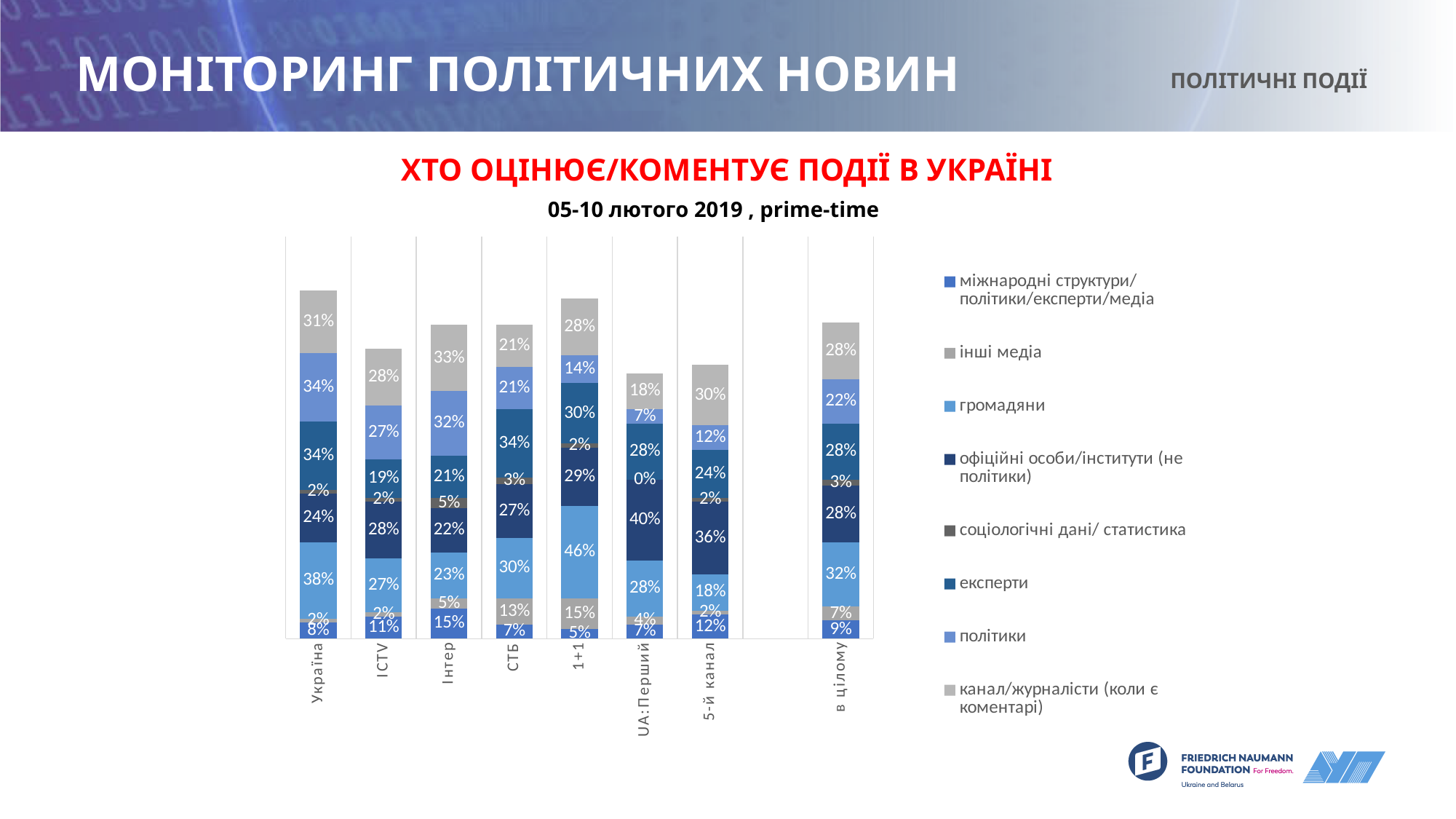
What type of chart is shown on the slide? Stacked bar chart What is the value of the 'громадяни' segment for 1+1? 46% What is the value of the 'офіційні особи/інститути (не політики)' segment for UA:Перший? 40% What is the value of the 'соціологічні дані/ статистика' segment for UA:Перший? 0% Which channel has the lowest value for 'міжнародні структури/політики/експерти/медіа'? 1+1 Which is larger: the 'політики' value for Україна or for ICTV? Україна What is the difference between the 'експерти' value for Україна and for 5-й канал? 10 percentage points How many series does the chart legend list? 8 What is the value of the 'міжнародні структури/політики/експерти/медіа' segment for Інтер? 15% What is the value of the 'канал/журналісти (коли є коментарі)' segment for Інтер? 33% Which channel has the highest value for 'громадяни'? 1+1 How many channels (categories) are shown along the x axis of the chart? 8